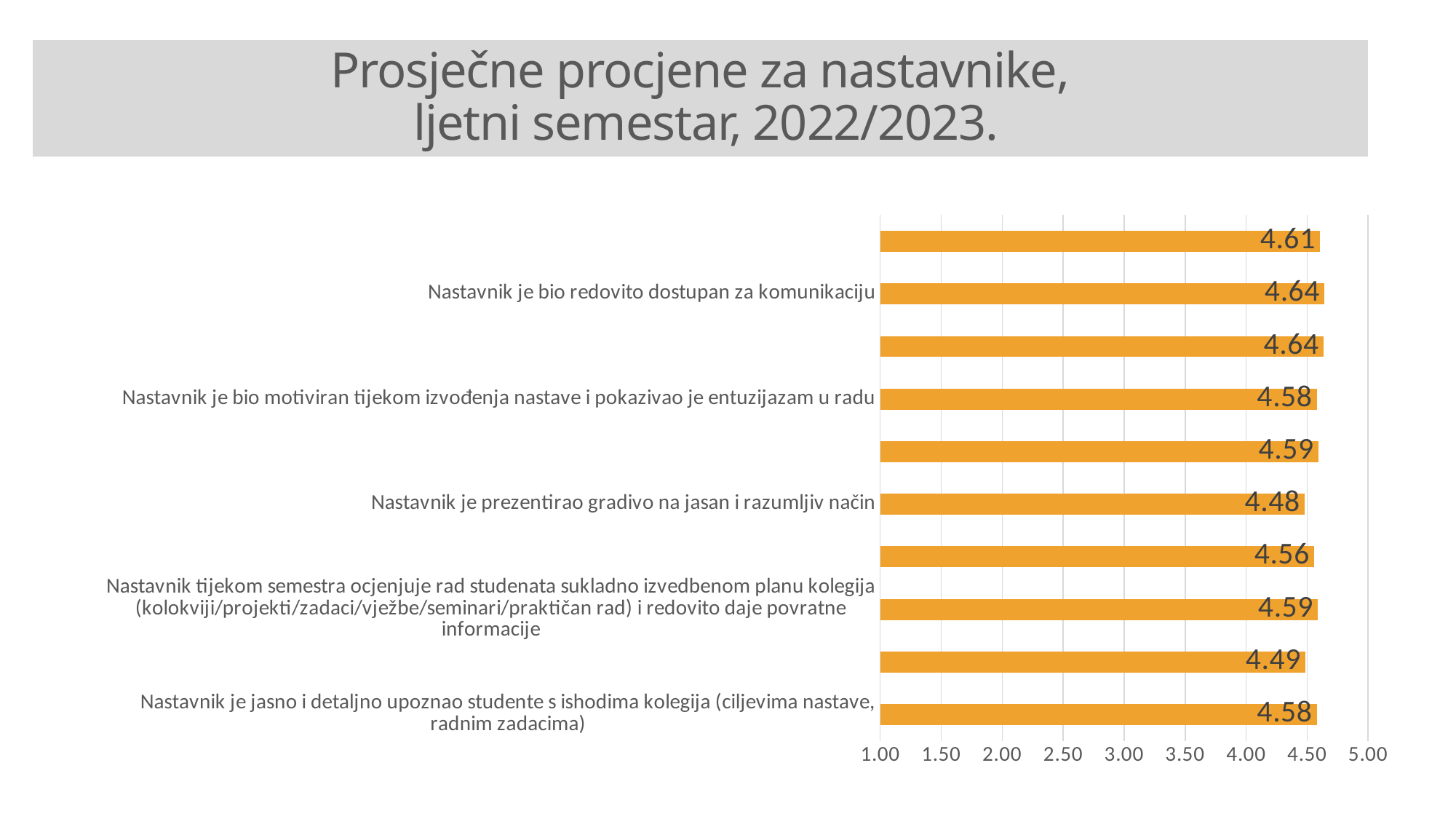
Is the value for "Nastavnik je jasno i detaljno upoznao studente s ishodima kolegija" greater or less than 4.00? greater What is the difference between the rating for "Nastavnik je bio redovito dostupan za komunikaciju" and the rating for "Nastavnik je prezentirao gradivo na jasan i razumljiv način"? 0.16 Which labelled statement has the lowest average rating? Nastavnik je prezentirao gradivo na jasan i razumljiv način What is the value for "Nastavnik tijekom semestra ocjenjuje rad studenata sukladno izvedbenom planu kolegija ... i redovito daje povratne informacije"? 4.59 What is the average rating for "Nastavnik je bio redovito dostupan za komunikaciju"? 4.64 What is the average rating for "Nastavnik je bio motiviran tijekom izvođenja nastave i pokazivao je entuzijazam u radu"? 4.58 What is the value shown for the topmost bar in the chart? 4.61 How many bars are plotted in the chart? 10 What is the average rating for "Nastavnik je prezentirao gradivo na jasan i razumljiv način"? 4.48 What is the highest value shown on any bar in the chart? 4.64 What type of chart is shown on the slide? Bar chart Which has a higher rating: "Nastavnik je bio redovito dostupan za komunikaciju" or "Nastavnik je prezentirao gradivo na jasan i razumljiv način"? Nastavnik je bio redovito dostupan za komunikaciju